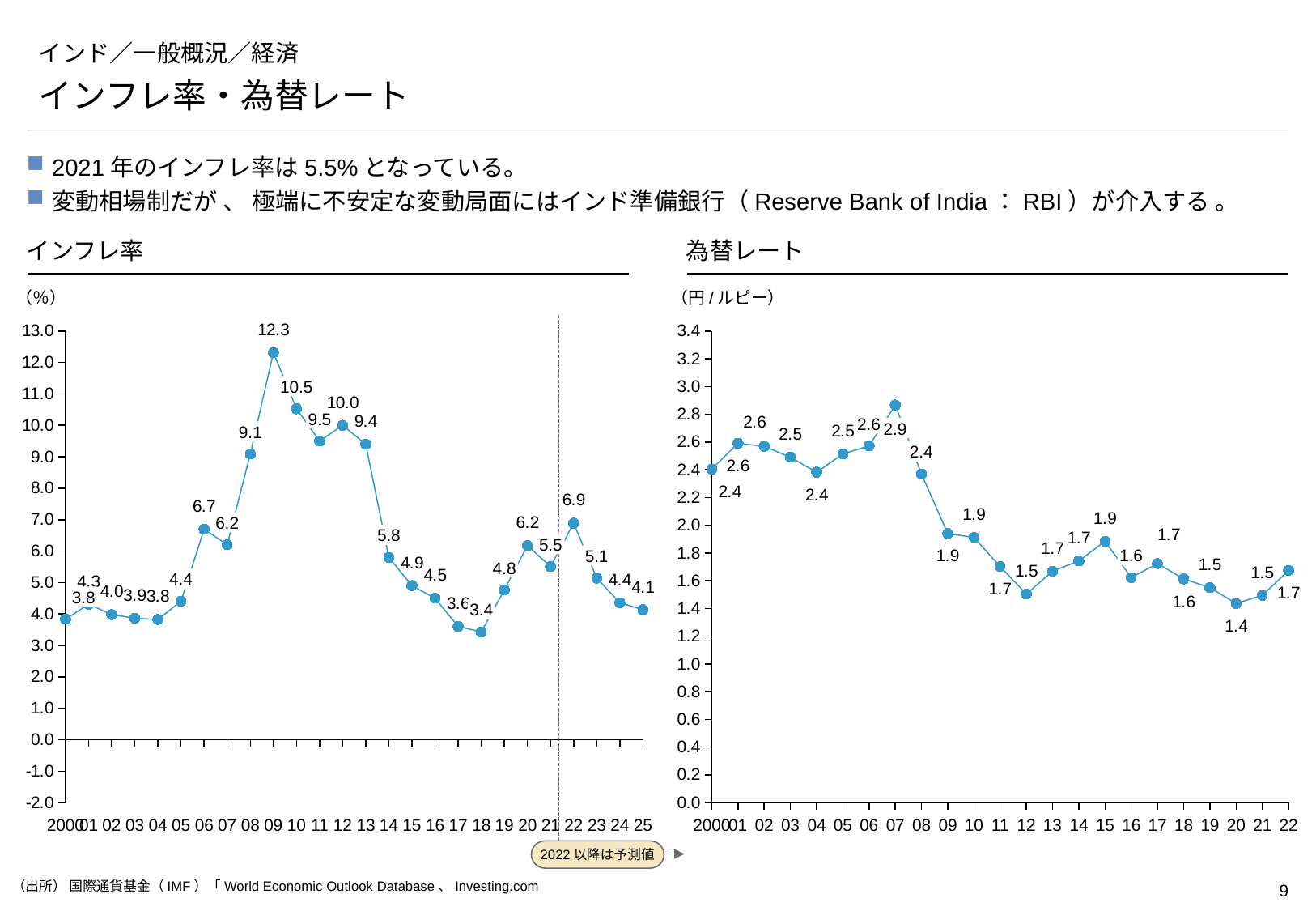
On the インフレ率 chart, what is the difference between the 2009 and 2010 values? 1.8 On the インフレ率 chart, how many years are plotted? 26 On the 為替レート chart, do the values rise or fall from 2007 to 2012? fall On the インフレ率 chart, which year has the highest inflation rate? 2009 On the 為替レート chart, what is the value for 2007? 2.9 What unit is shown for the 為替レート chart? 円/ルピー On the 為替レート chart, which year has the lowest value? 2020 What kind of chart is the 為替レート chart? line chart On the インフレ率 chart, what is the inflation rate for 2021? 5.5 On the インフレ率 chart, what is the inflation rate for 2009? 12.3 On the インフレ率 chart, which year has the higher value, 2006 or 2007? 2006 On the インフレ率 chart, which year has the lowest inflation rate? 2018